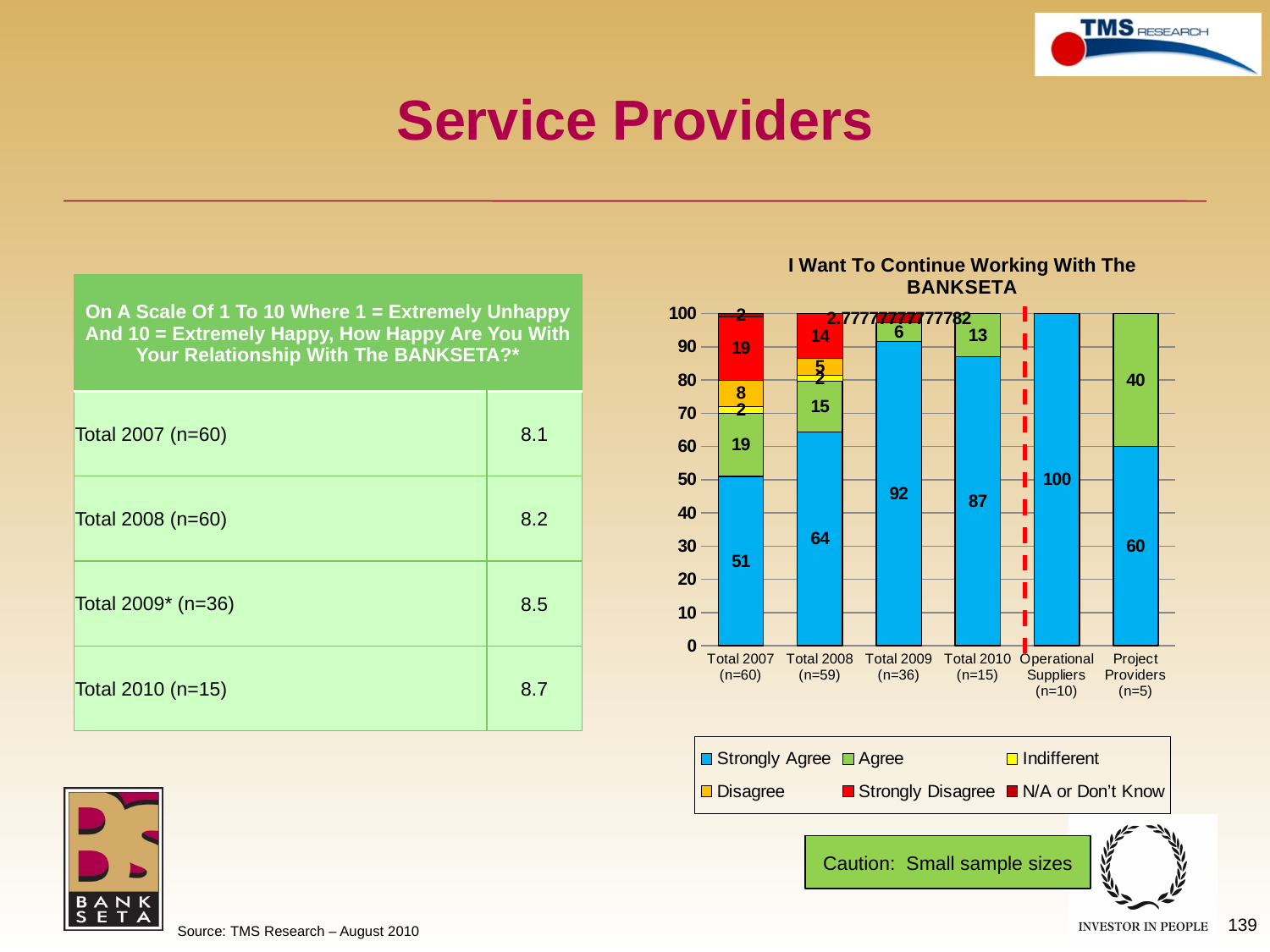
What kind of chart is shown on the slide? bar chart Does the Strongly Agree value rise or fall from Total 2007 to Total 2010? rise What is the Strongly Agree value for Total 2009 (n=36)? 92 What is the Strongly Agree value for Total 2007 (n=60)? 51 Which category has the lowest Strongly Agree value? Total 2007 (n=60) How many categories are shown on the x axis of the chart? 6 What is the difference between the Strongly Agree values for Total 2008 (n=59) and Total 2007 (n=60)? 13 Which is larger, the Strongly Agree value for Total 2010 (n=15) or for Project Providers (n=5)? Total 2010 (n=15) What is the Strongly Disagree value for Total 2007 (n=60)? 19 What is the Agree value for Project Providers (n=5)? 40 Which category has the highest Strongly Agree value? Operational Suppliers (n=10) How many series does the chart legend list? 6